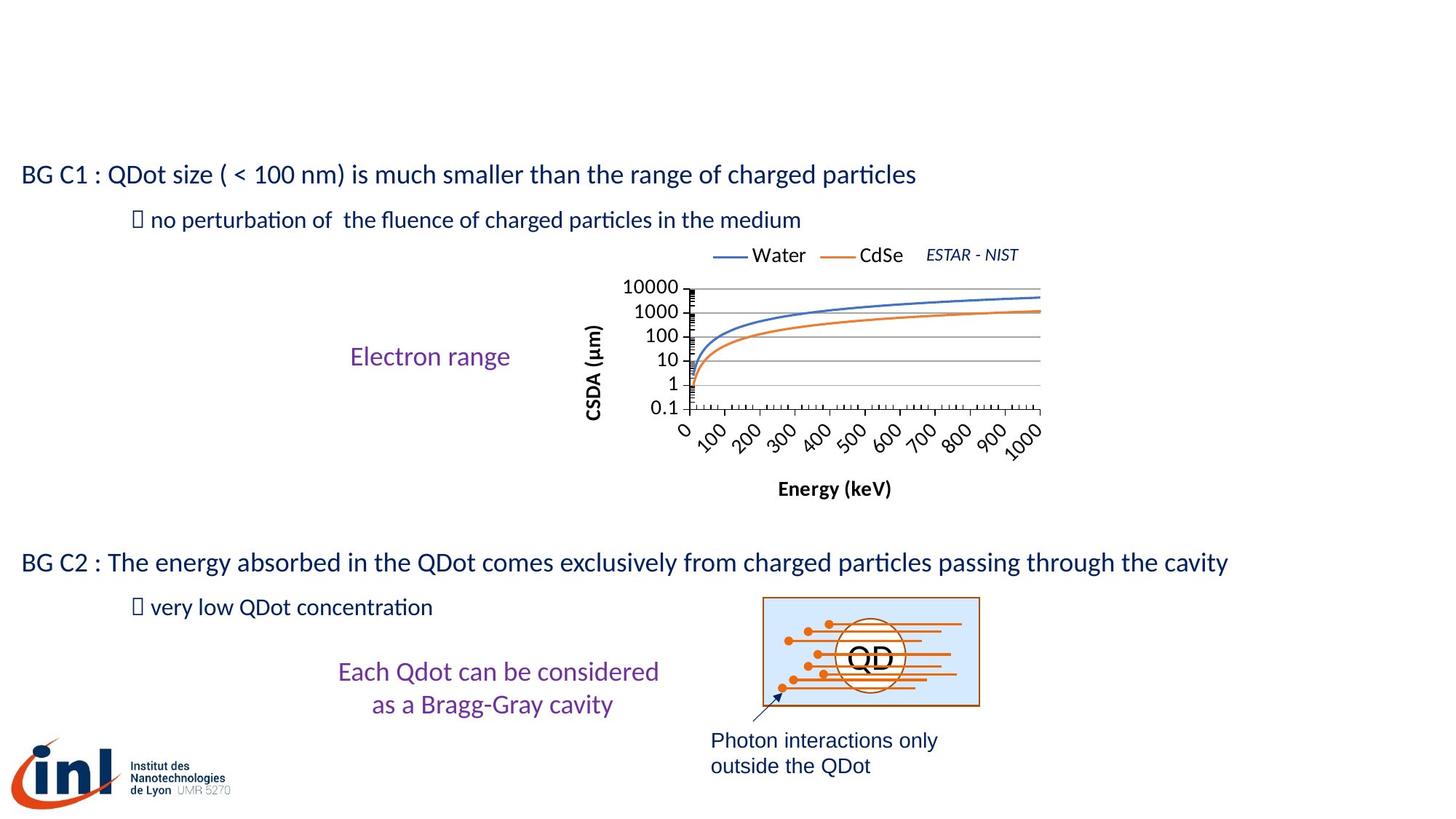
What kind of chart is shown on the slide? line chart Do the CSDA values rise or fall as energy increases along the x axis? rise Which series reaches the highest CSDA value at 1000 keV? Water Is the CSDA value for CdSe at 100 keV greater or less than 100? less Is the CSDA value for CdSe at 500 keV greater or less than 1000? less How many series does the chart legend list? 2 Which series has the lowest CSDA value across the plotted energy range? CdSe What is the label of the chart's x axis? Energy (keV) Which series has the higher CSDA value at 500 keV, Water or CdSe? Water Is the CSDA value for Water at 1000 keV greater or less than 1000? greater Which two series are listed in the chart legend? Water and CdSe